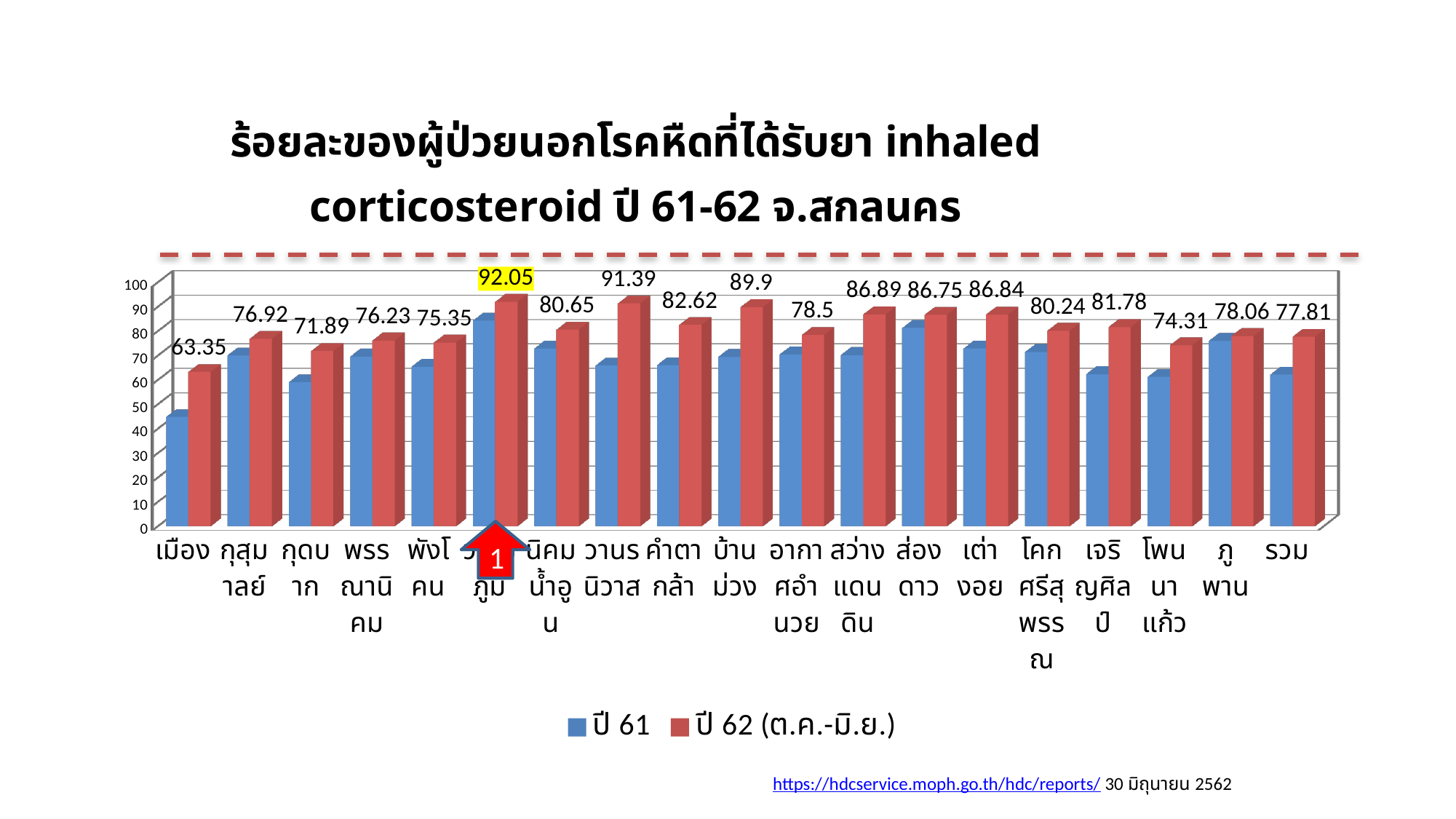
Which category has the highest value for ปี 62 (ต.ค.-มิ.ย.)? วาริชภูมิ How many series does the legend list? 2 What is the value for ปี 62 (ต.ค.-มิ.ย.) for วานรนิวาส? 91.39 Is the ปี 61 value for เมือง greater or less than 50? less What is the value for ปี 62 (ต.ค.-มิ.ย.) for รวม? 77.81 What is the difference between the ปี 62 (ต.ค.-มิ.ย.) values for กุสุมาลย์ and เมือง? 13.57 Which has the larger ปี 62 (ต.ค.-มิ.ย.) value, คำตากล้า or บ้านม่วง? บ้านม่วง Which category has the lowest value for ปี 62 (ต.ค.-มิ.ย.)? เมือง What type of chart is shown on the slide? bar chart What are the two legend entries of the chart? ปี 61 and ปี 62 (ต.ค.-มิ.ย.) How many categories are shown along the x axis? 19 What is the value for ปี 62 (ต.ค.-มิ.ย.) for เมือง? 63.35